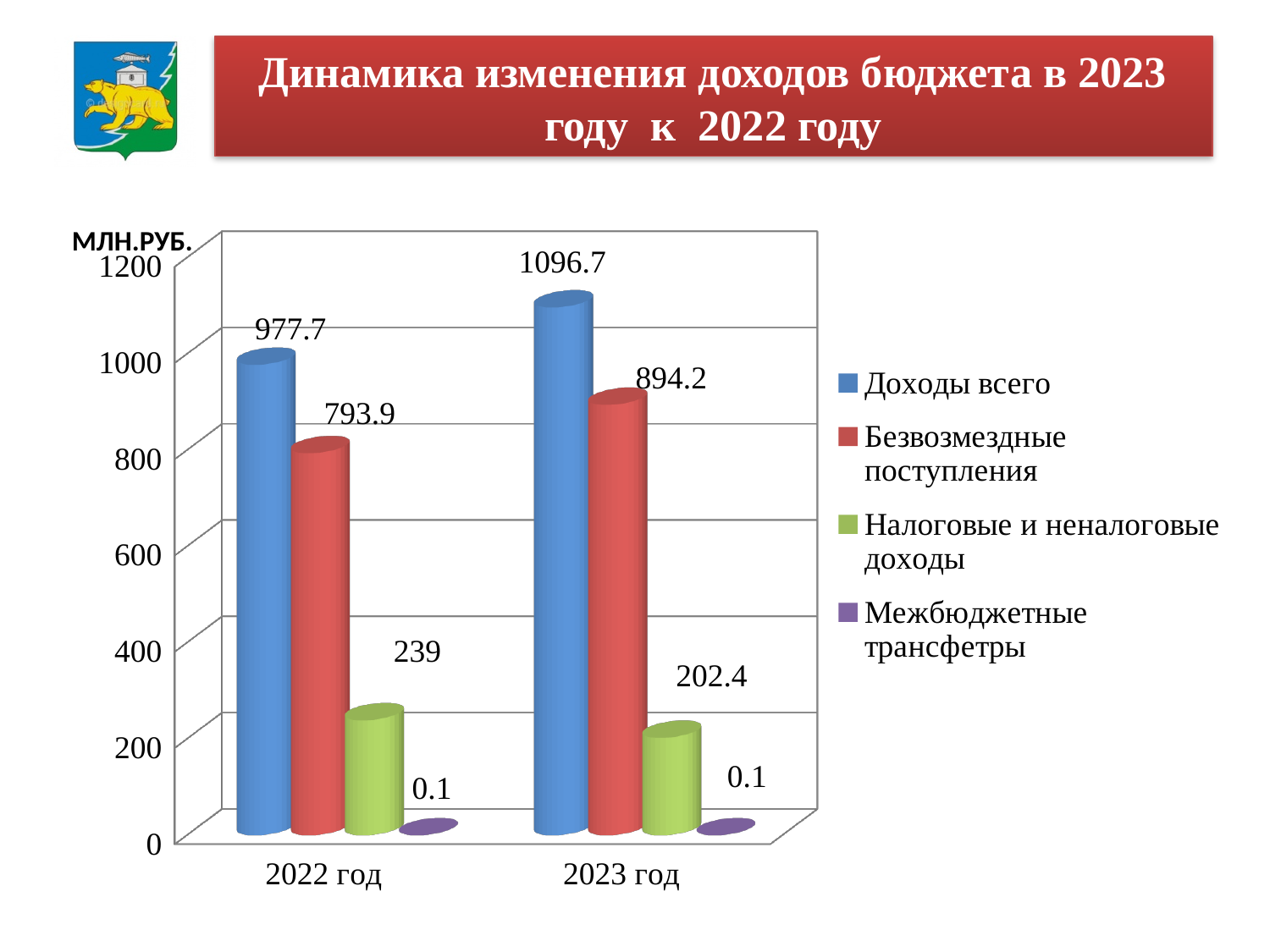
What is the value of Доходы всего for 2023 год? 1096.7 Which series has the highest value for 2022 год? Доходы всего What is the difference between Безвозмездные поступления in 2023 год and 2022 год? 100.3 What is the value of Межбюджетные трансферты for 2022 год? 0.1 What is the value of Безвозмездные поступления for 2022 год? 793.9 How many series does the legend list? 4 Which series has the lowest value for 2023 год? Межбюджетные трансферты What is the value of Налоговые и неналоговые доходы for 2023 год? 202.4 What unit is shown on the vertical axis of the chart? МЛН.РУБ. Which is larger: Налоговые и неналоговые доходы in 2022 год or in 2023 год? 2022 год By how much did Доходы всего change from 2022 год to 2023 год? 119 What kind of chart is shown on the slide? Bar chart